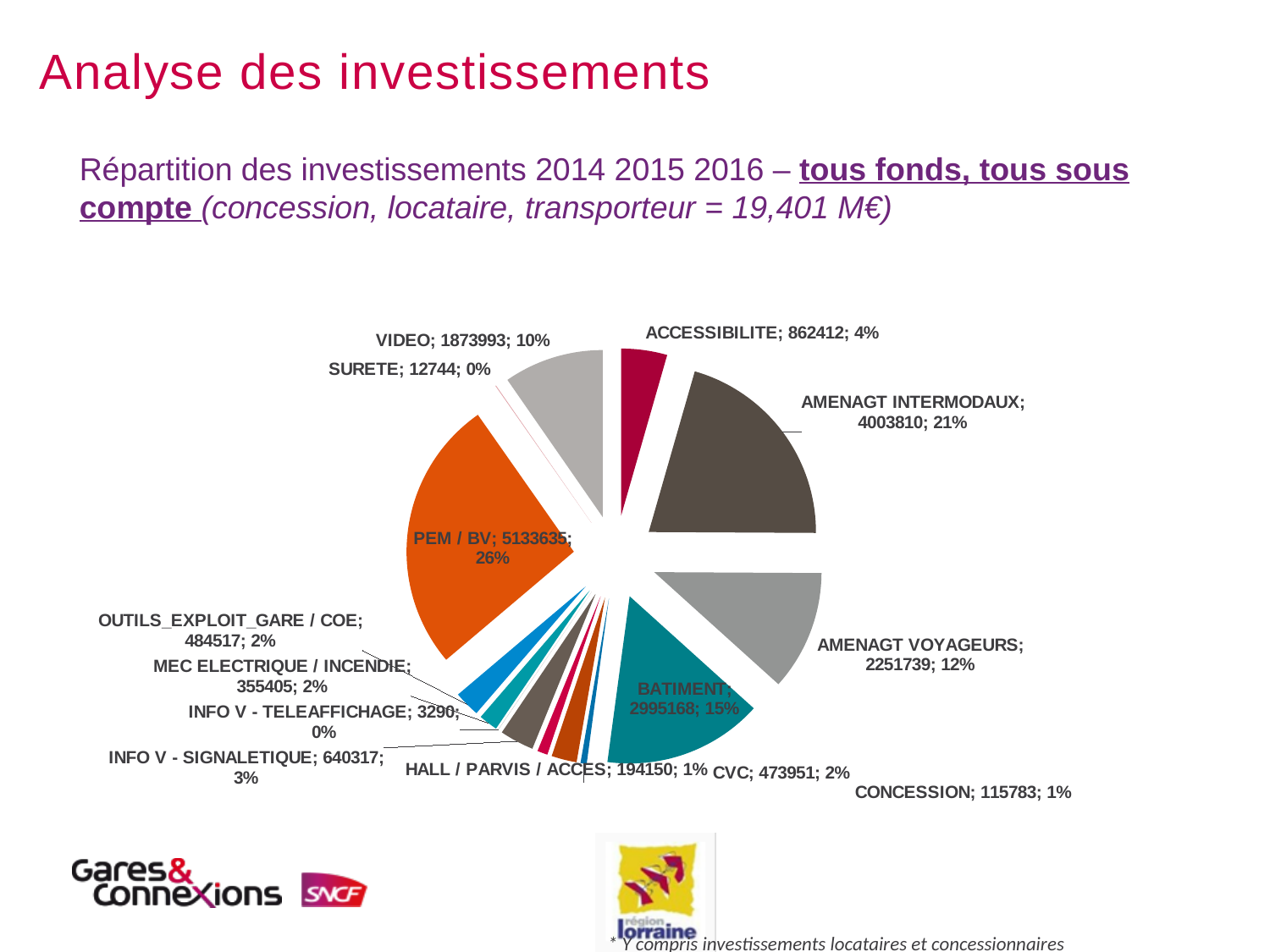
What share of the pie does AMENAGT VOYAGEURS represent? 12% Which category has the smallest value? INFO V - TELEAFFICHAGE What share of the pie does VIDEO represent? 10% Which category has the largest slice of the pie? PEM / BV What is the value for AMENAGT INTERMODAUX? 4003810 What is the value for PEM / BV? 5133635 What is the difference between the values for BATIMENT and AMENAGT VOYAGEURS? 743429 What is the difference between the values for PEM / BV and AMENAGT INTERMODAUX? 1129825 How many categories are shown in the pie chart? 14 Which is larger, the value for CVC or the value for CONCESSION? CVC What is the value for BATIMENT? 2995168 What kind of chart is shown on the slide? pie chart